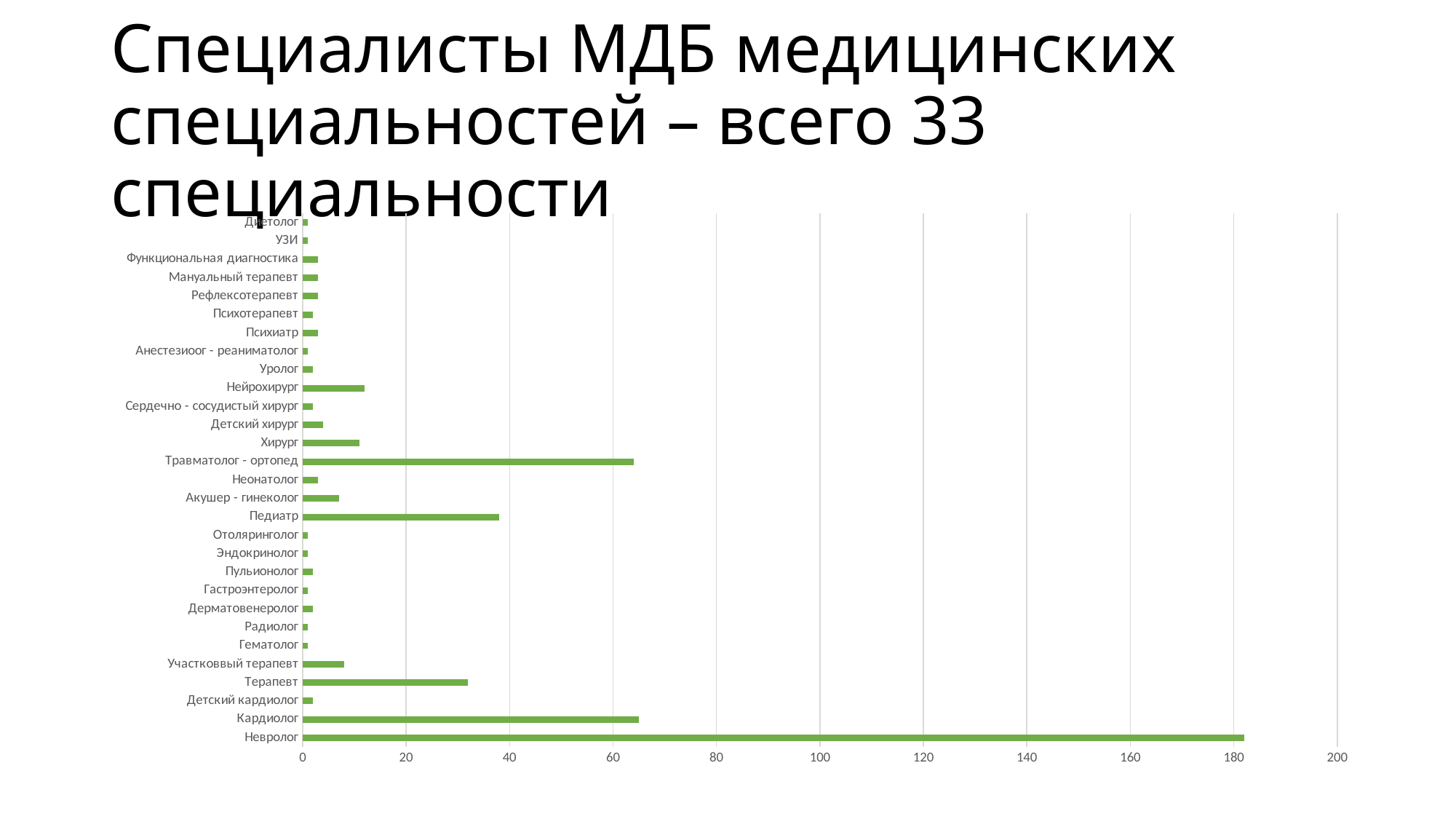
What kind of chart is shown on the slide? bar chart Is the value for Травматолог - ортопед greater or less than 80? less Is the value for Кардиолог greater or less than 60? greater Is the value for Терапевт greater or less than 20? greater Which has a larger value, Невролог or Кардиолог? Невролог What colour are the bars in the chart? green What is the maximum value shown on the horizontal axis? 200 Which has a larger value, Травматолог - ортопед or Педиатр? Травматолог - ортопед Which has a larger value, Педиатр or Терапевт? Педиатр Which specialty has the highest value in the chart? Невролог